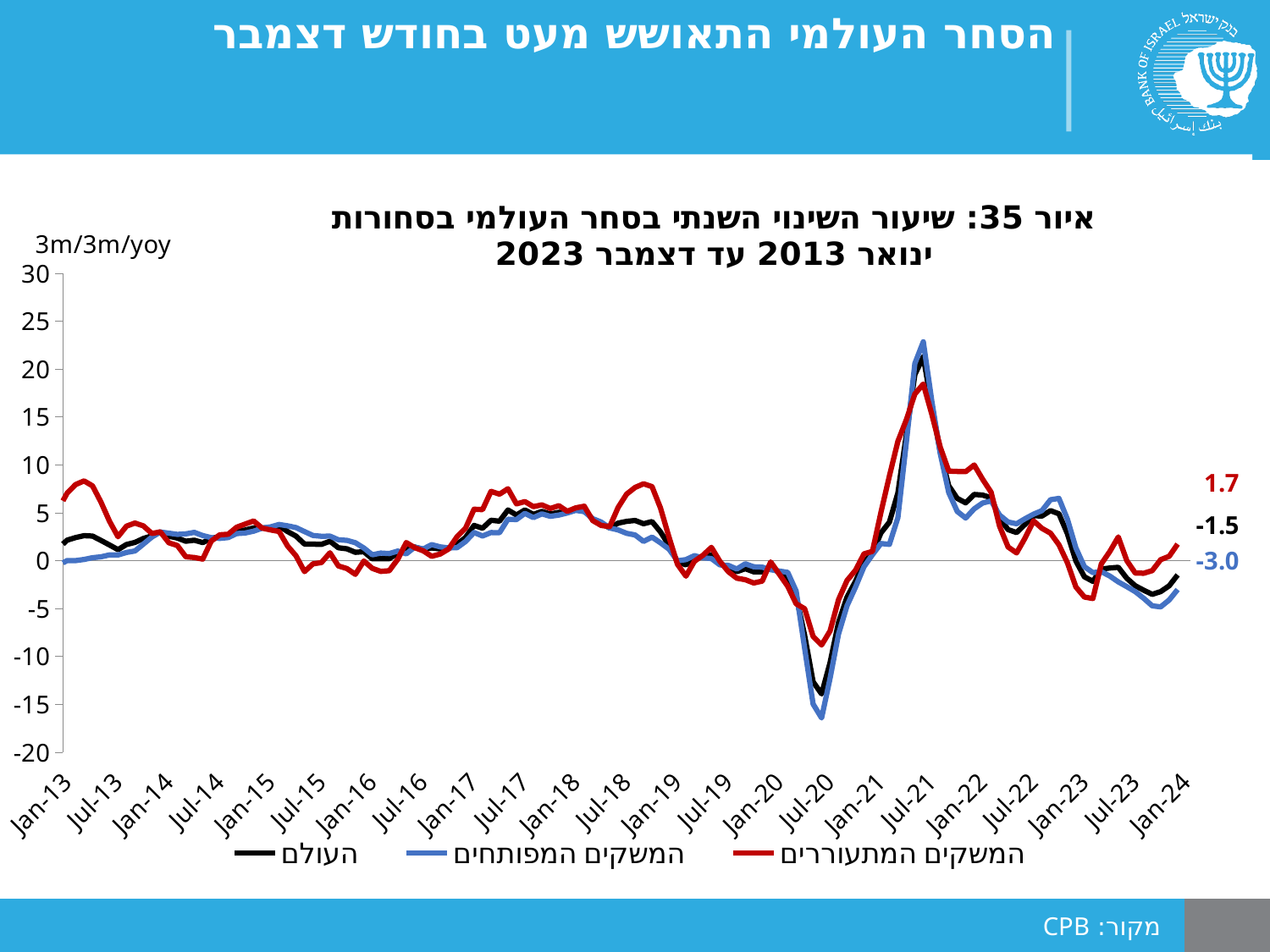
Which series has the lowest latest value labelled at the right end of the chart? המשקים המפותחים What is the latest value shown for the world (העולם) series? -1.5 What unit label is shown at the top of the vertical axis? 3m/3m/yoy What kind of chart is shown on the slide? line chart What is the latest value shown for the emerging economies (המשקים המתעוררים) series? 1.7 What is the difference between the latest labelled values of the emerging economies series (1.7) and the developed economies series (-3.0)? 4.7 Which series has the highest latest value labelled at the right end of the chart? המשקים המתעוררים What is the latest value shown for the developed economies (המשקים המפותחים) series? -3.0 Is the peak value of the developed economies (blue) series around Jul-21 greater or less than 20? greater How many series does the legend list? 3 Is the lowest value of the developed economies (blue) series around Jul-20 greater or less than -15? less Is the latest labelled value for the world series larger or smaller than that of the developed economies series? larger